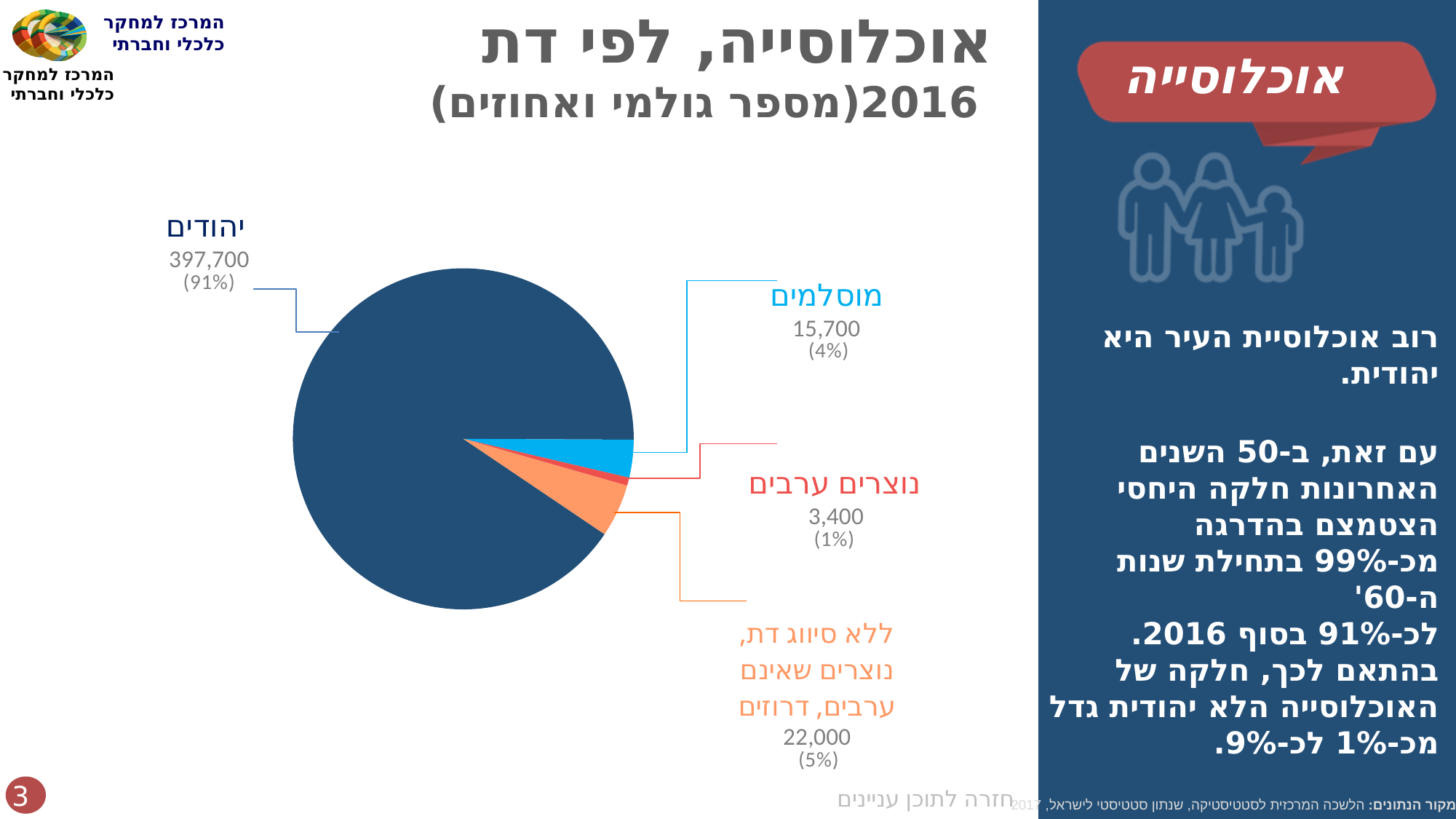
What percentage share is shown for יהודים (Jews)? 91% Which category has the smallest slice of the pie? נוצרים ערבים What is the value shown for נוצרים ערבים (Arab Christians)? 3,400 Which is larger: the value for מוסלמים or the value for ללא סיווג דת, נוצרים שאינם ערבים, דרוזים? ללא סיווג דת, נוצרים שאינם ערבים, דרוזים What is the difference between the value for מוסלמים and the value for נוצרים ערבים? 12,300 What percentage share is shown for מוסלמים (Muslims)? 4% What is the value shown for the slice labelled ללא סיווג דת, נוצרים שאינם ערבים, דרוזים? 22,000 What is the value shown for יהודים (Jews) in the pie chart? 397,700 What kind of chart is shown on the slide? Pie chart How many slices does the pie chart have? 4 What is the value shown for מוסלמים (Muslims)? 15,700 Which category has the largest slice of the pie? יהודים